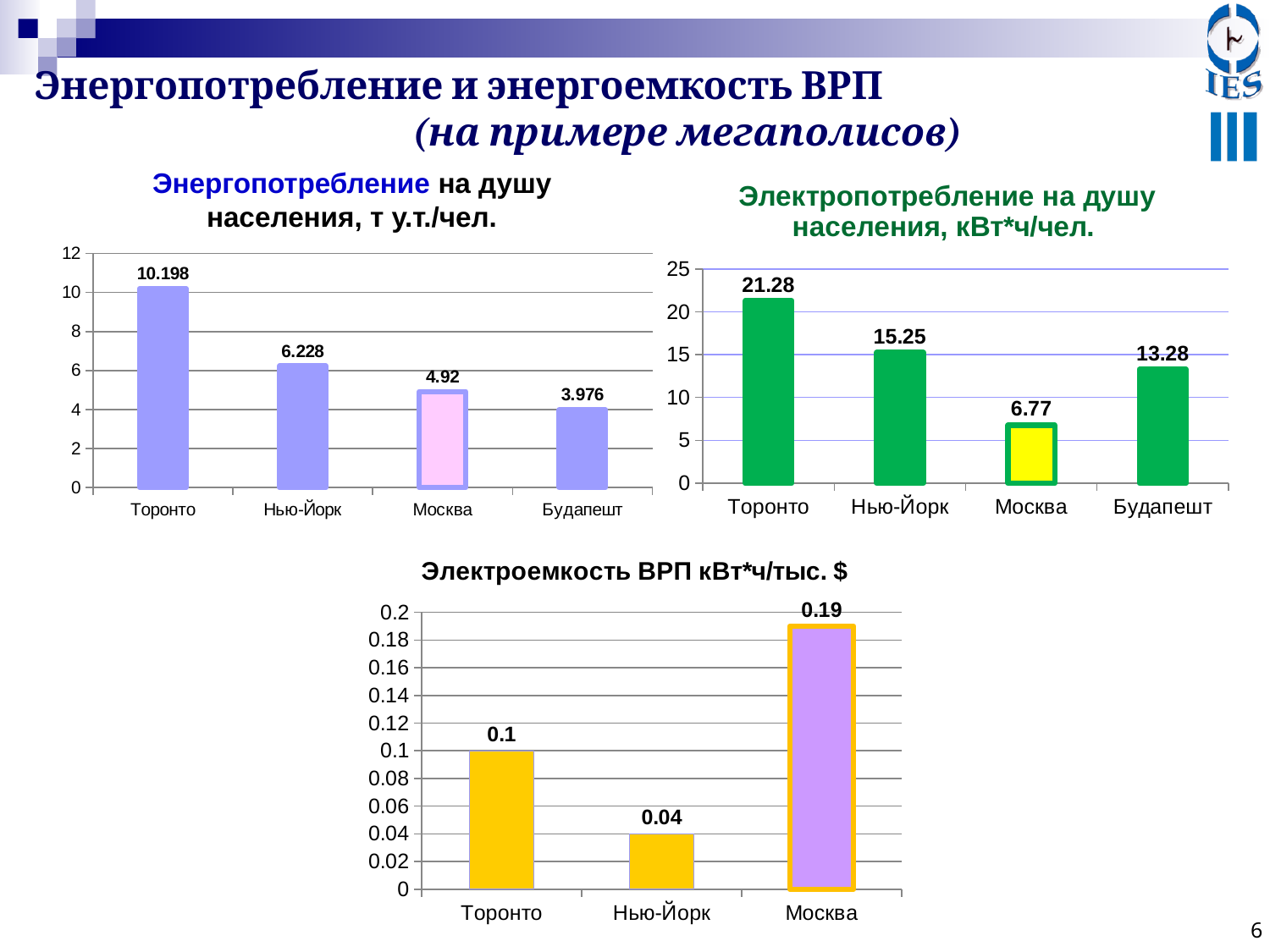
In the chart titled "Энергопотребление на душу населения, т у.т./чел.", which city has the highest value? Торонто In the chart titled "Электропотребление на душу населения, кВт*ч/чел.", which is larger, the value for Нью-Йорк or Будапешт? Нью-Йорк In the chart titled "Энергопотребление на душу населения, т у.т./чел.", what is the difference between the values for Торонто and Нью-Йорк? 3.97 What kind of chart is the chart titled "Электроемкость ВРП кВт*ч/тыс. $"? Bar chart In the chart titled "Электроемкость ВРП кВт*ч/тыс. $", what is the value for Нью-Йорк? 0.04 In the chart titled "Электропотребление на душу населения, кВт*ч/чел.", what is the value for Будапешт? 13.28 In the chart titled "Электропотребление на душу населения, кВт*ч/чел.", which city has the lowest value? Москва In the chart titled "Электроемкость ВРП кВт*ч/тыс. $", which city has the highest value? Москва In the chart titled "Электропотребление на душу населения, кВт*ч/чел.", how many cities are shown? 4 In the chart titled "Электроемкость ВРП кВт*ч/тыс. $", how many cities are shown? 3 In the chart titled "Энергопотребление на душу населения, т у.т./чел.", what is the value for Москва? 4.92 In the chart titled "Энергопотребление на душу населения, т у.т./чел.", which city has the lowest value? Будапешт